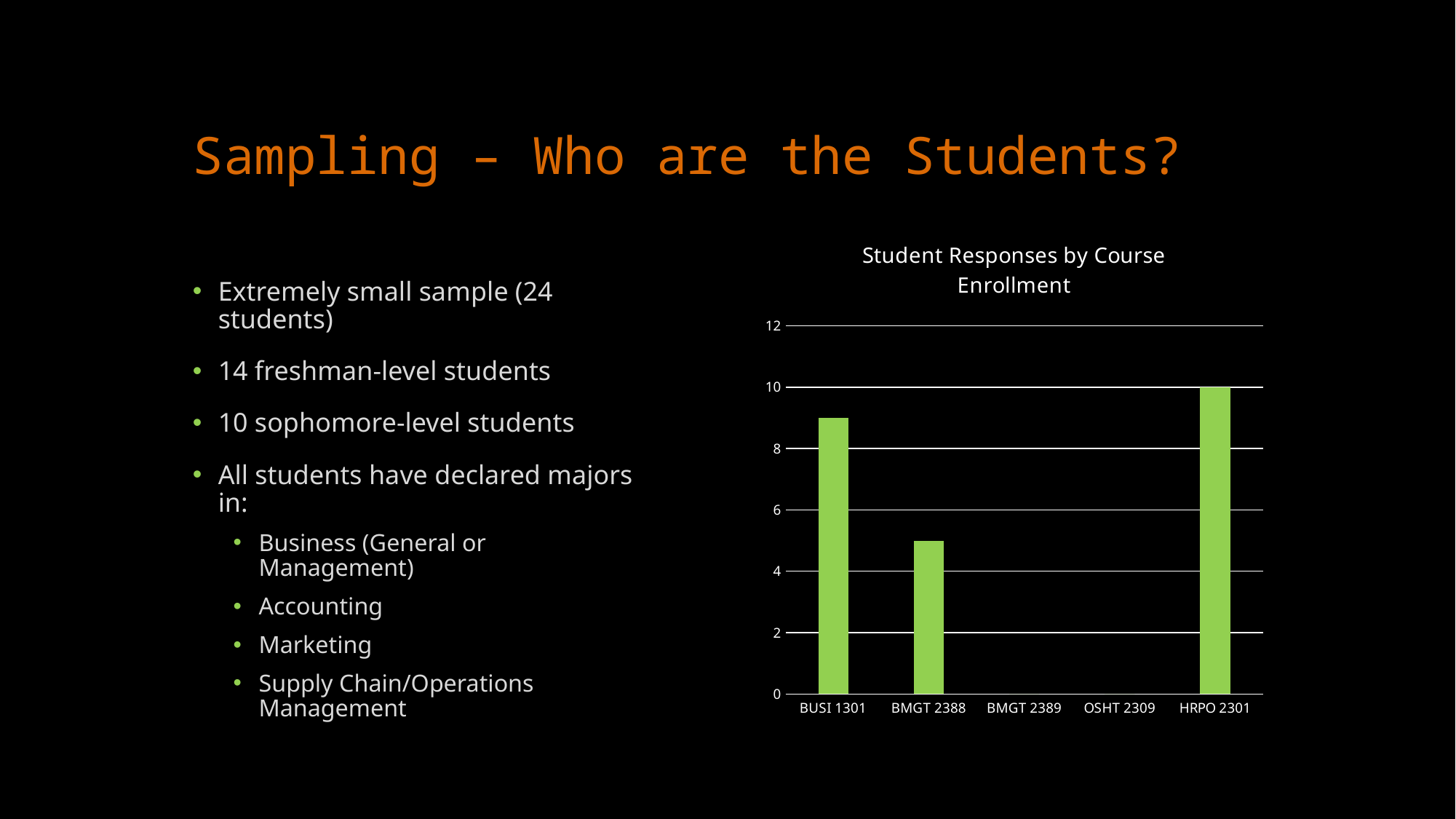
How many courses on the chart show no bar at all? 2 Is the value for BMGT 2388 greater or less than 4? greater What colour are the bars in the chart? green Which has more student responses, BUSI 1301 or BMGT 2388? BUSI 1301 Which course has the highest number of student responses? HRPO 2301 Is the value for BMGT 2388 greater or less than 6? less Is the value for BUSI 1301 greater or less than 8? greater What is the value for HRPO 2301? 10 What is the title of the chart? Student Responses by Course Enrollment How many courses are listed on the x axis of the chart? 5 What kind of chart is shown on the slide? bar chart